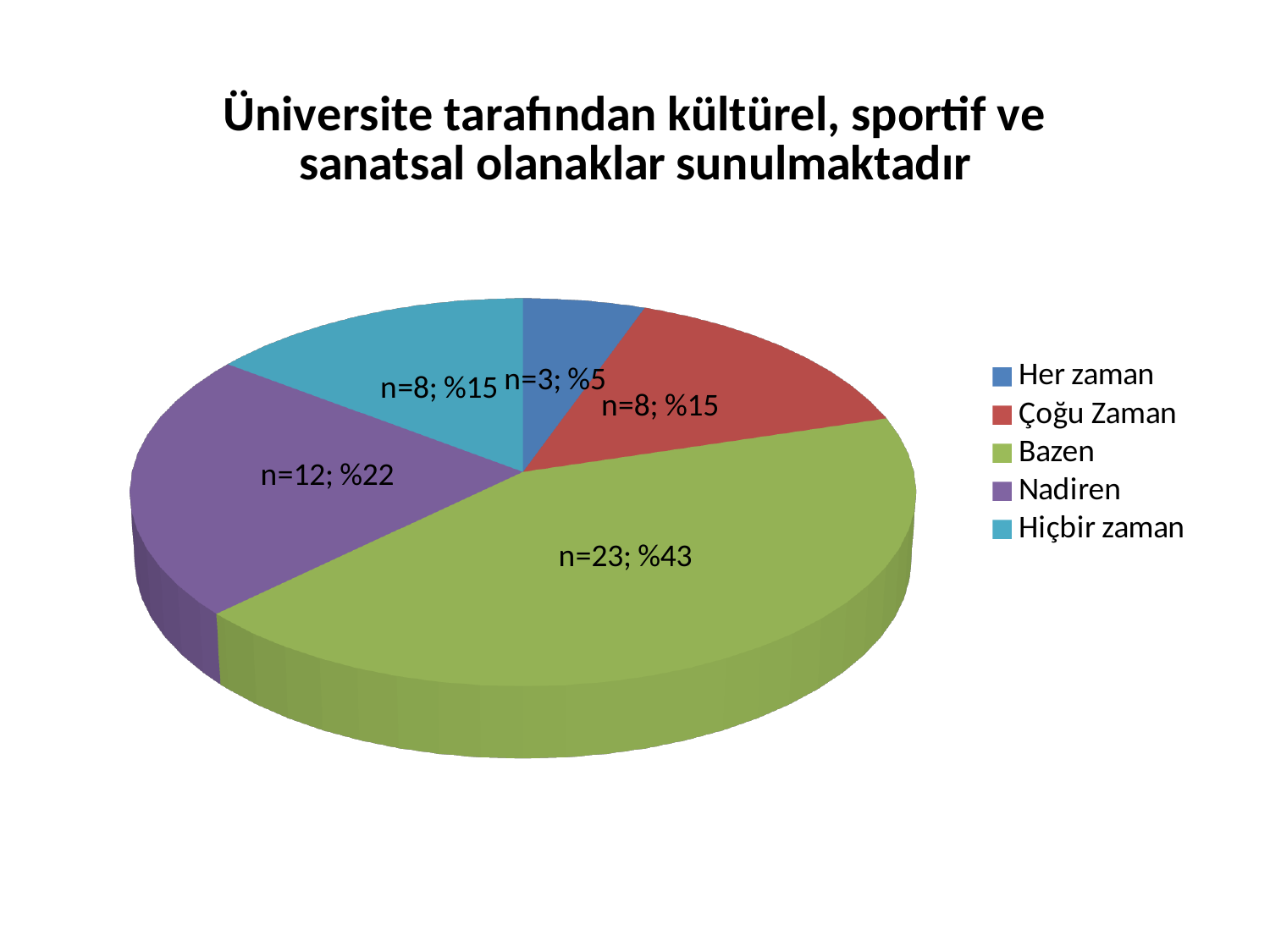
What is the title of the chart? Üniversite tarafından kültürel, sportif ve sanatsal olanaklar sunulmaktadır What percentage share does the Bazen slice have? %43 How many categories does the pie chart have? 5 What is the difference in count (n) between Bazen and Nadiren? 11 What is the count (n) for the Her zaman slice? n=3 Which category has the largest slice? Bazen Which is larger, the Nadiren slice or the Çoğu Zaman slice? Nadiren What kind of chart is shown on the slide? pie chart What is the count (n) for the Bazen slice? n=23 Which category has the smallest slice? Her zaman Which colour represents Hiçbir zaman in the legend? teal (light blue) What percentage share does the Nadiren slice have? %22